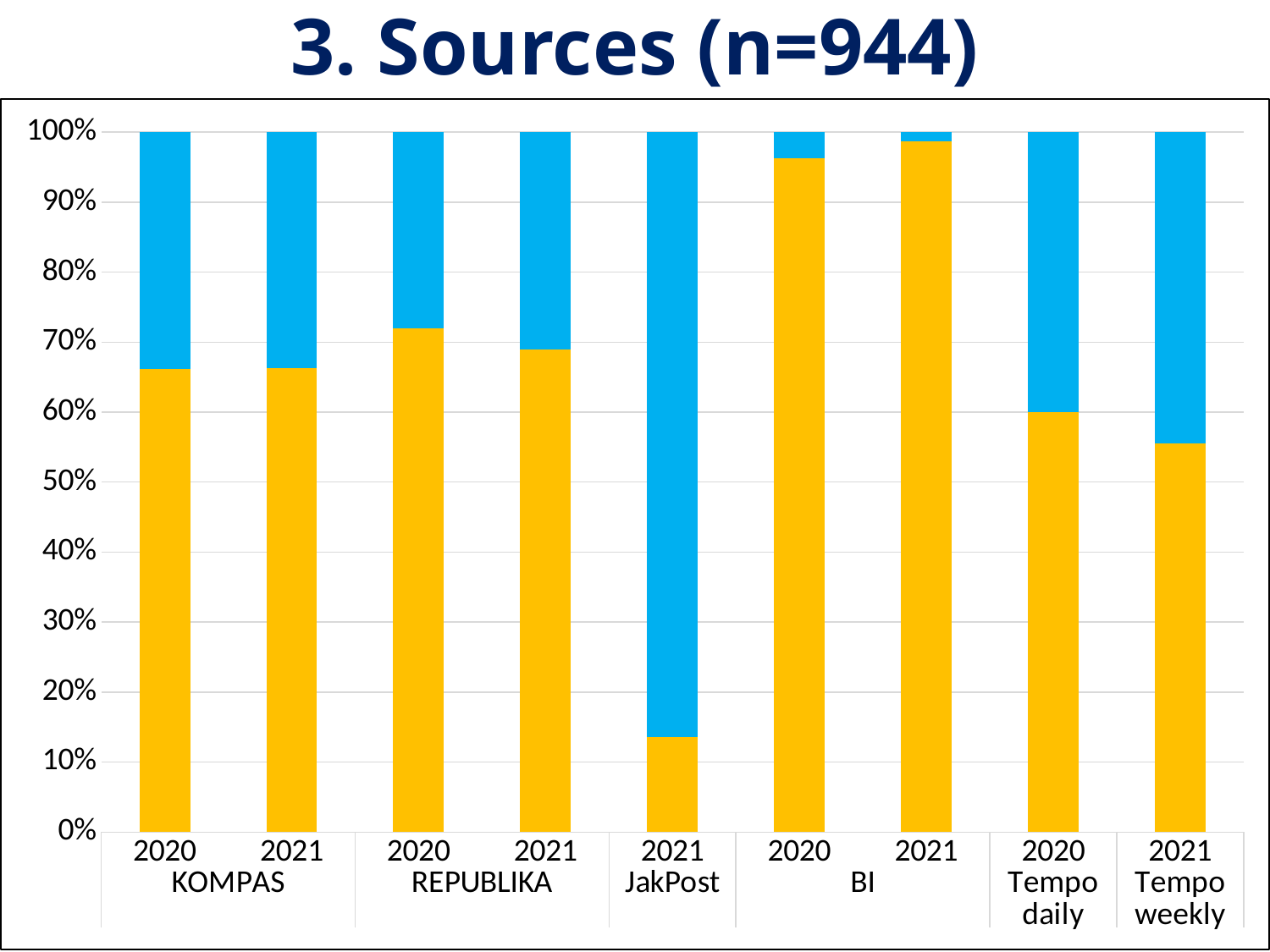
What is the highest value shown on the vertical axis? 100% Which bar has the largest blue segment? 2021 JakPost What kind of chart is shown on the slide? Stacked bar chart Is the yellow segment for 2021 JakPost greater or less than 20%? less Is the yellow segment for 2020 BI greater or less than 90%? greater Which bar has the smallest yellow segment? 2021 JakPost Is the yellow segment for 2020 KOMPAS greater or less than 60%? greater Which has the larger yellow segment, 2020 Tempo daily or 2021 Tempo weekly? 2020 Tempo daily What is the title of the chart on the slide? 3. Sources (n=944) Which has the larger yellow segment, 2020 KOMPAS or 2020 REPUBLIKA? 2020 REPUBLIKA How many bars are plotted in the chart? 9